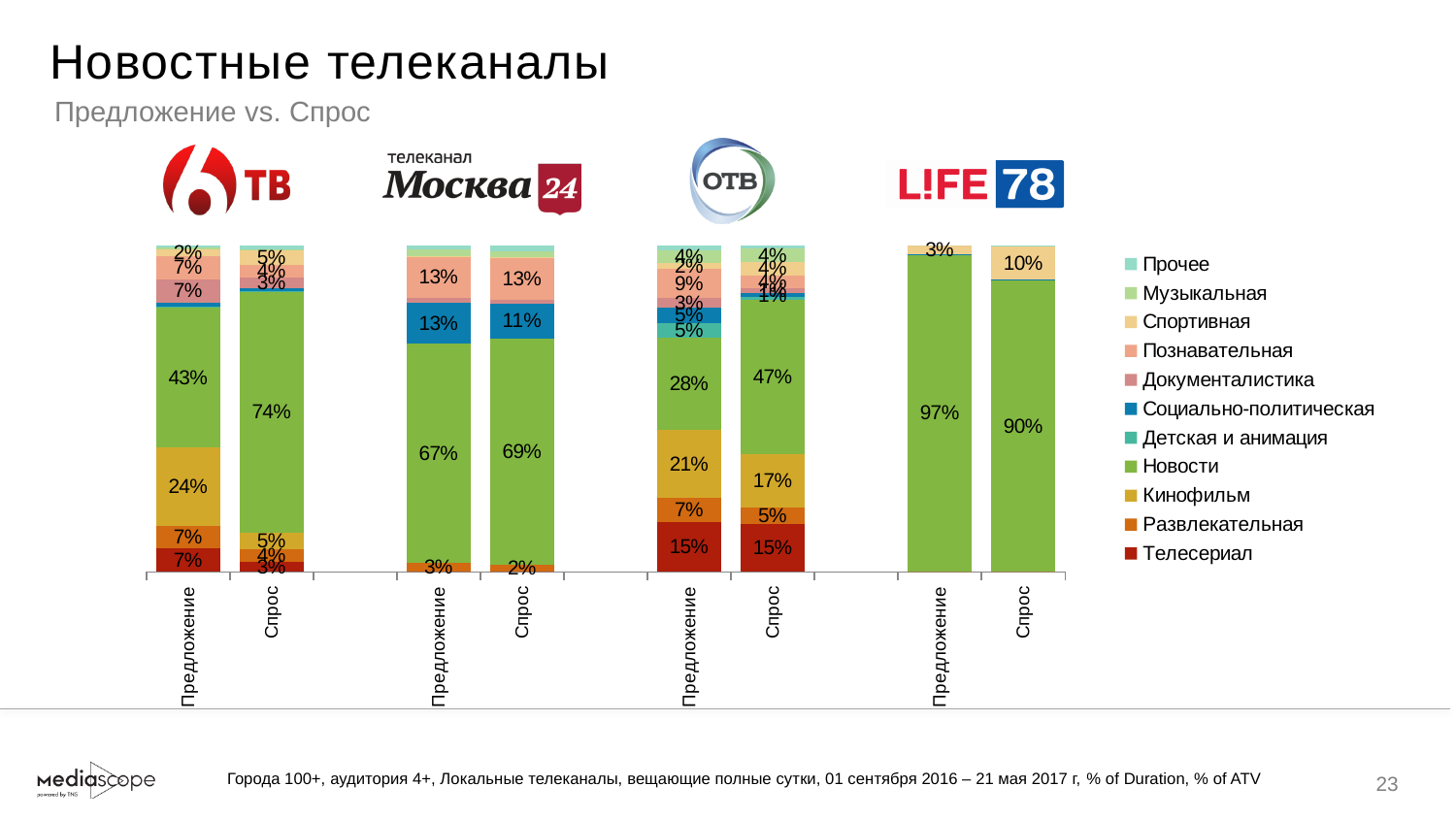
In the Москва 24 chart, what is the value of Новости for Предложение? 67% What kind of chart is used on this slide? Stacked bar chart In the ОТВ chart, what is the value of Новости for Спрос? 47% In the 6ТВ chart, what is the value of Кинофильм for Предложение? 24% How many bars does each channel's chart have? 2 In the LIFE 78 chart, what is the value of Новости for Предложение? 97% In the ОТВ chart, what is the difference between the Кинофильм value for Предложение and for Спрос? 4% In the 6ТВ chart, what is the difference between the Новости value for Спрос and for Предложение? 31% How many series does the legend list? 11 In the Москва 24 chart, what is the value of Новости for Спрос? 69% In the LIFE 78 chart, what is the value of Спортивная for Спрос? 10% In the Москва 24 chart, which is larger: Социально-политическая for Предложение or for Спрос? Предложение